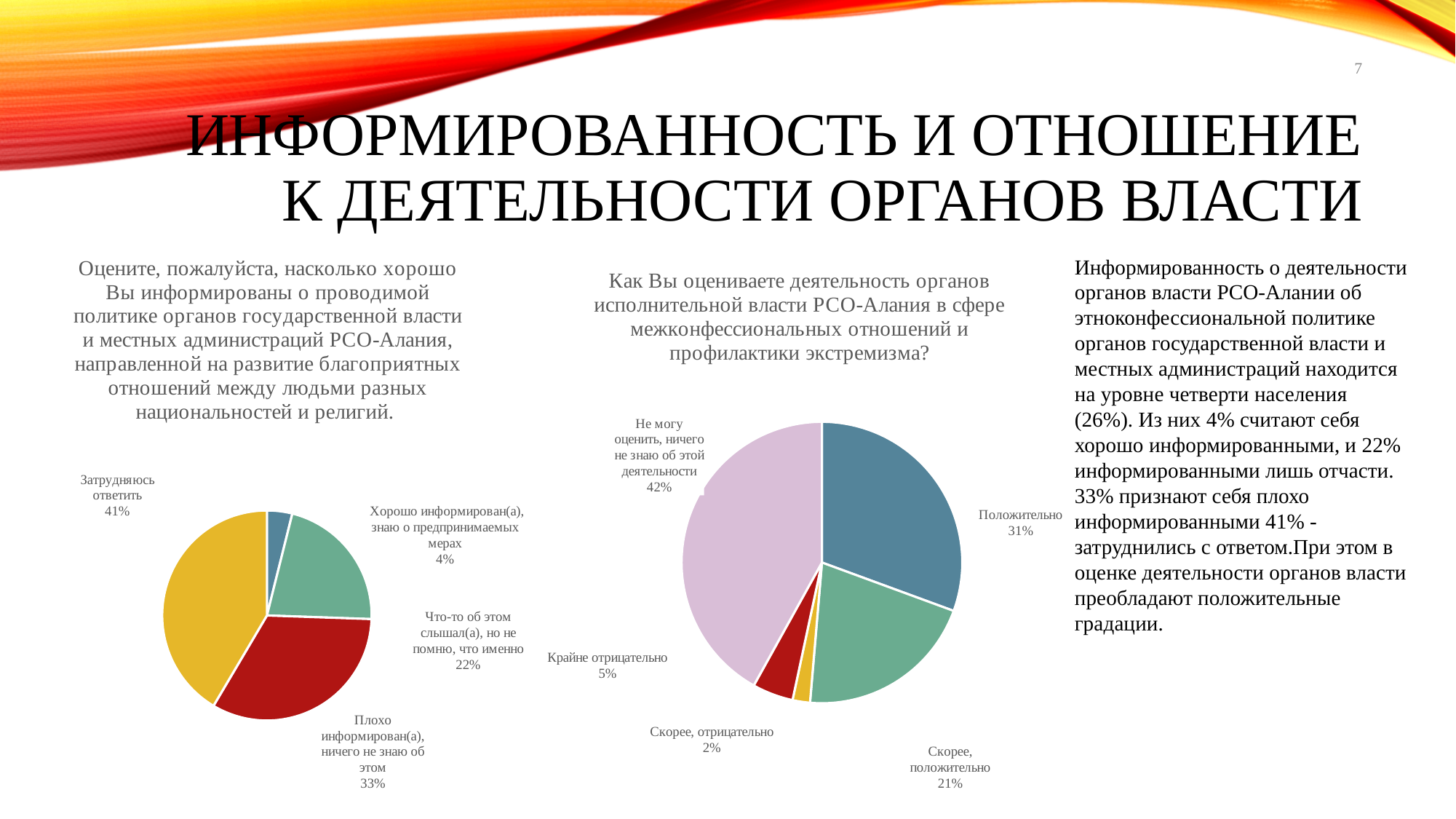
In the right pie chart, which is larger: "Скорее, положительно" or "Скорее, отрицательно"? Скорее, положительно In the left pie chart, what share is labelled "Хорошо информирован(а), знаю о предпринимаемых мерах"? 4% In the right pie chart, which category has the largest share? Не могу оценить, ничего не знаю об этой деятельности What type of chart is the left chart on the slide? Pie chart In the left pie chart, which category has the largest share? Затрудняюсь ответить How many slices does the left pie chart have? 4 In the right pie chart, what share is labelled "Крайне отрицательно"? 5% In the left pie chart (about how well respondents are informed), what share is labelled "Затрудняюсь ответить"? 41% In the right pie chart (about evaluating the activity of executive authorities), what share is labelled "Положительно"? 31% In the left pie chart, which category has the smallest share? Хорошо информирован(а), знаю о предпринимаемых мерах How many slices does the right pie chart have? 5 In the left pie chart, what is the difference between the shares for "Плохо информирован(а)" and "Что-то об этом слышал(а)"? 11%